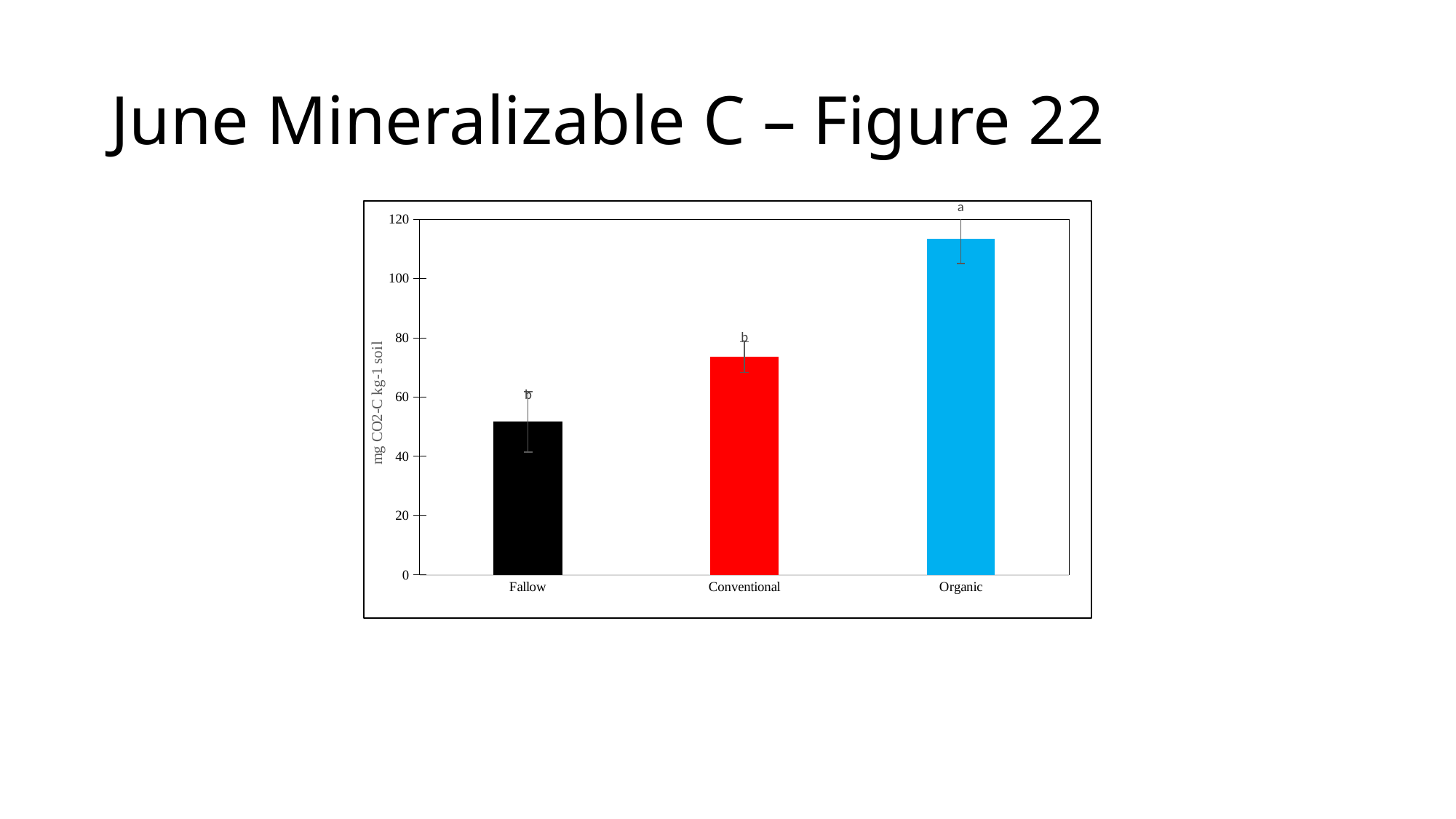
What colour is the bar for Organic? blue Is the value for Organic greater or less than 100? greater Is the value for Conventional greater or less than 60? greater Which category has the highest value? Organic What kind of chart is shown on the slide? bar chart What is the label on the y axis? mg CO2-C kg-1 soil Which is larger, the value for Conventional or the value for Fallow? Conventional Which category has the lowest value? Fallow How many categories are shown on the x axis? 3 Is the value for Fallow greater or less than 60? less Do the values rise or fall from Fallow to Organic along the x axis? rise